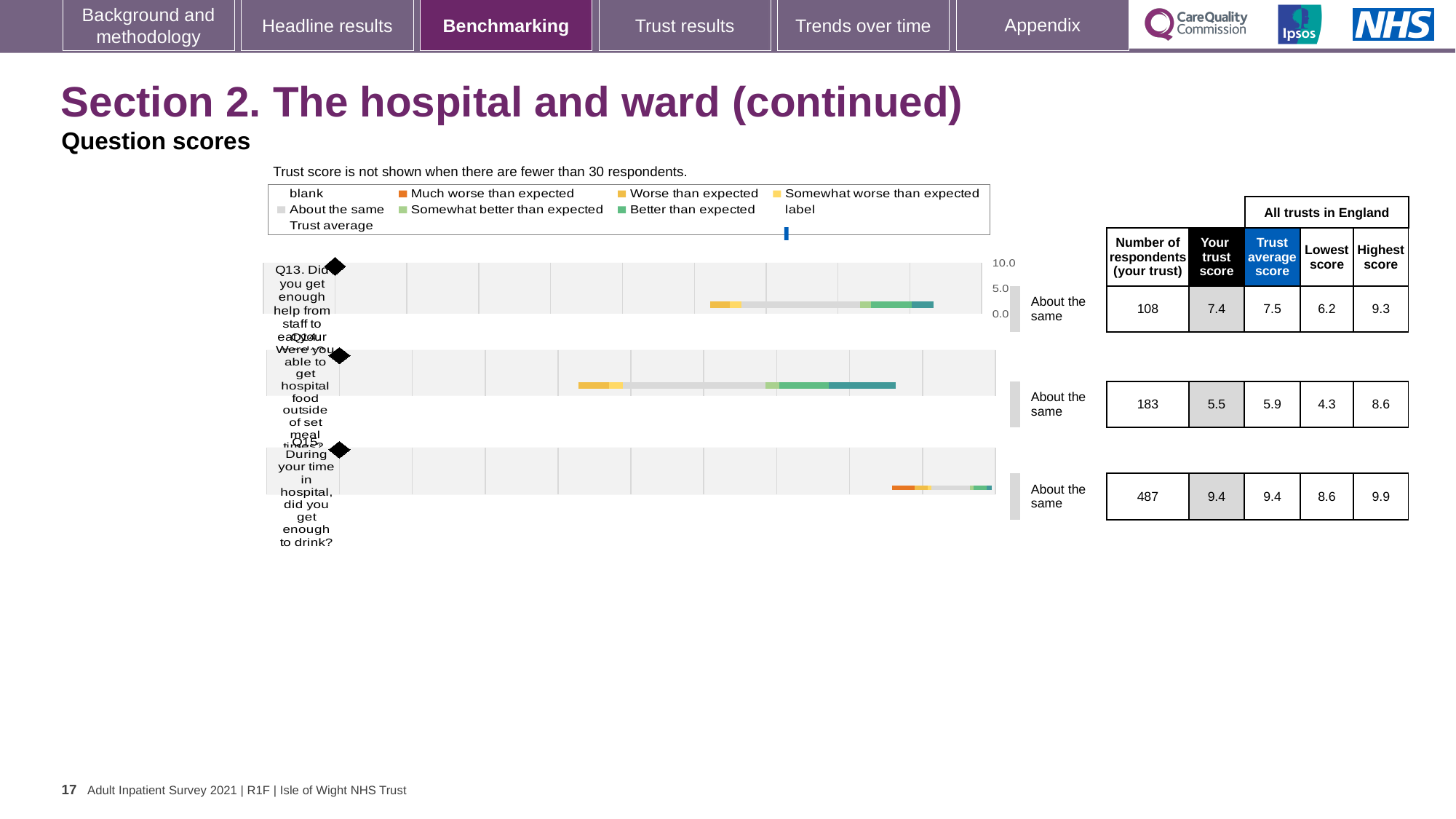
How many respondents from the trust answered Q14 (Were you able to get hospital food outside of set meal times?)? 183 For Q14, which is larger: the trust's own score or the trust average score? Trust average score (5.9) Which question has the highest 'Your trust score'? Q15 Is the trust score for Q15 greater or less than 5.0 on the chart axis? greater What kind of chart is used to show the question scores on this slide? bar chart For Q14, what is the difference between the highest score and the lowest score across all trusts in England? 4.3 Which question has the lowest 'Your trust score'? Q14 How many questions (Q13, Q14, Q15) are plotted on the slide? 3 What benchmark category is shown next to the Q13 bar? About the same What is the lowest score across all trusts in England for Q14? 4.3 What is the 'Your trust score' for Q13 (Did you get enough help from staff to eat your meals?)? 7.4 What is the highest score across all trusts in England for Q15 (did you get enough to drink?)? 9.9